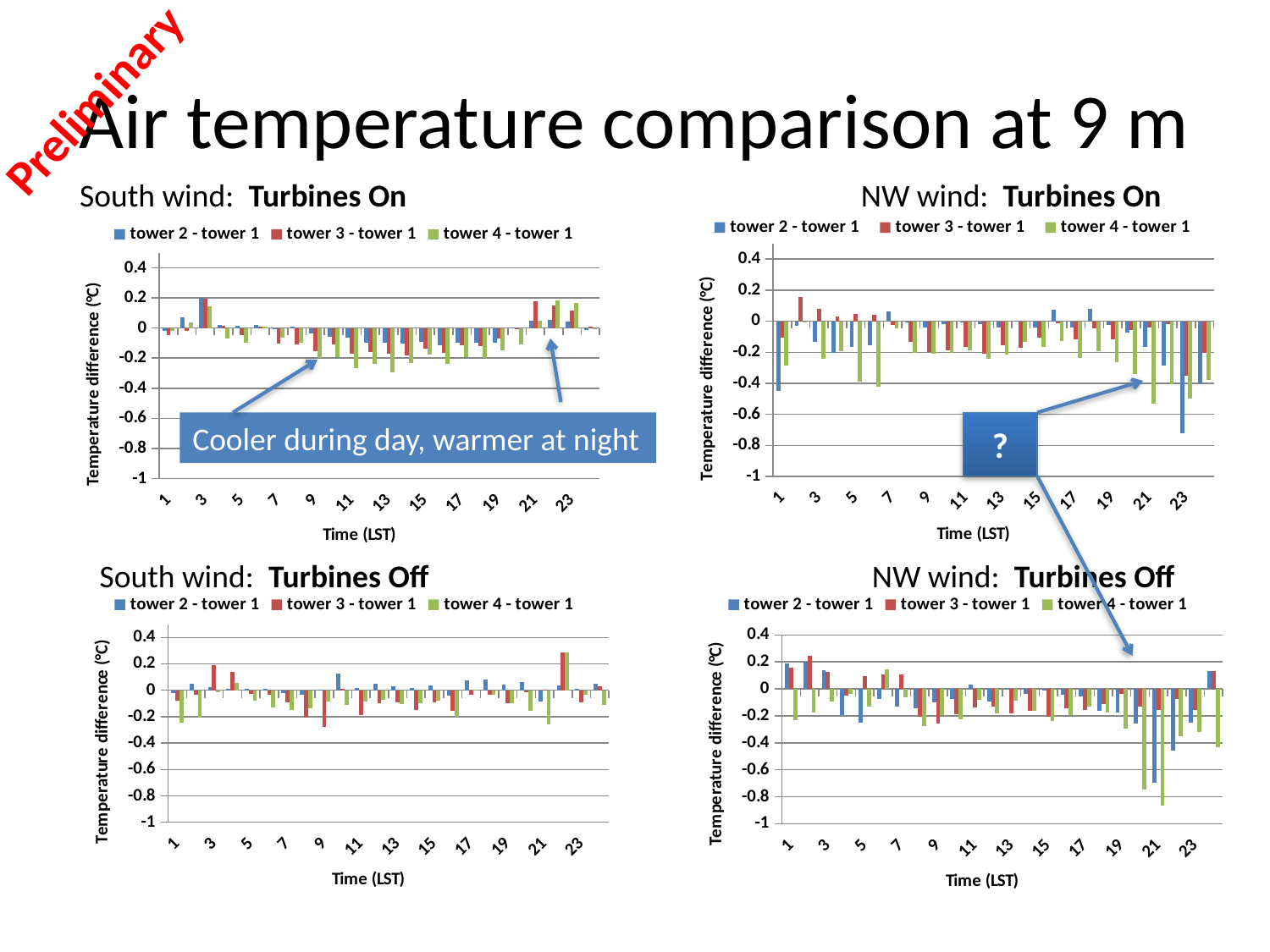
In the 'South wind: Turbines On' chart, is the value for tower 4 - tower 1 at hour 12 greater or less than -0.2? less In the 'NW wind: Turbines Off' chart, is the value for tower 4 - tower 1 at hour 21 greater or less than -0.8? less What kind of chart is the 'South wind: Turbines On' chart? bar chart How many series does the legend of the 'NW wind: Turbines Off' chart list? 3 In the 'South wind: Turbines Off' chart, what is the label of the series shown in green? tower 4 - tower 1 In the 'NW wind: Turbines On' chart, is the value for tower 2 - tower 1 at hour 23 greater or less than -0.6? less What is the x-axis title of the 'NW wind: Turbines On' chart? Time (LST) In the 'NW wind: Turbines Off' chart, which is larger at hour 21: the value for tower 2 - tower 1 or the value for tower 4 - tower 1? tower 2 - tower 1